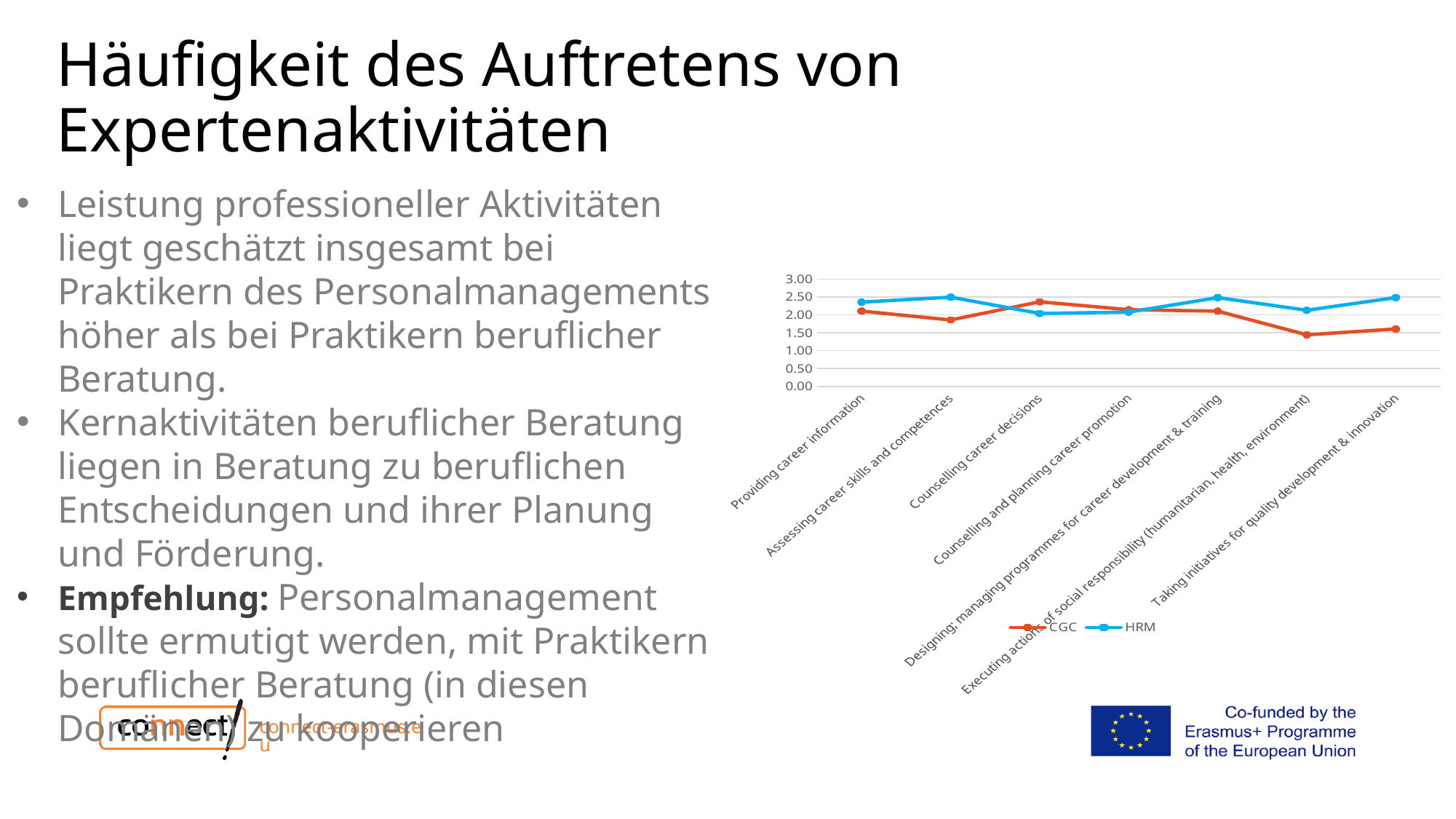
Is the CGC value for "Executing actions of social responsibility (humanitarian, health, environment)" greater or less than 2.00? less For "Assessing career skills and competences", which series has the higher value, CGC or HRM? HRM How many activity categories are plotted along the x axis? 7 How many series does the chart's legend list? 2 Is the HRM value for "Taking initiatives for quality development & innovation" greater or less than 2.00? greater Does the CGC line rise or fall from "Designing, managing programmes for career development & training" to "Executing actions of social responsibility (humanitarian, health, environment)"? fall What kind of chart is shown on the slide? line chart For which category is the CGC value lowest? Executing actions of social responsibility (humanitarian, health, environment) For "Counselling career decisions", which series has the higher value, CGC or HRM? CGC For which category is the CGC value highest? Counselling career decisions Which two series are listed in the chart's legend? CGC and HRM Is the CGC value for "Taking initiatives for quality development & innovation" greater or less than 2.00? less